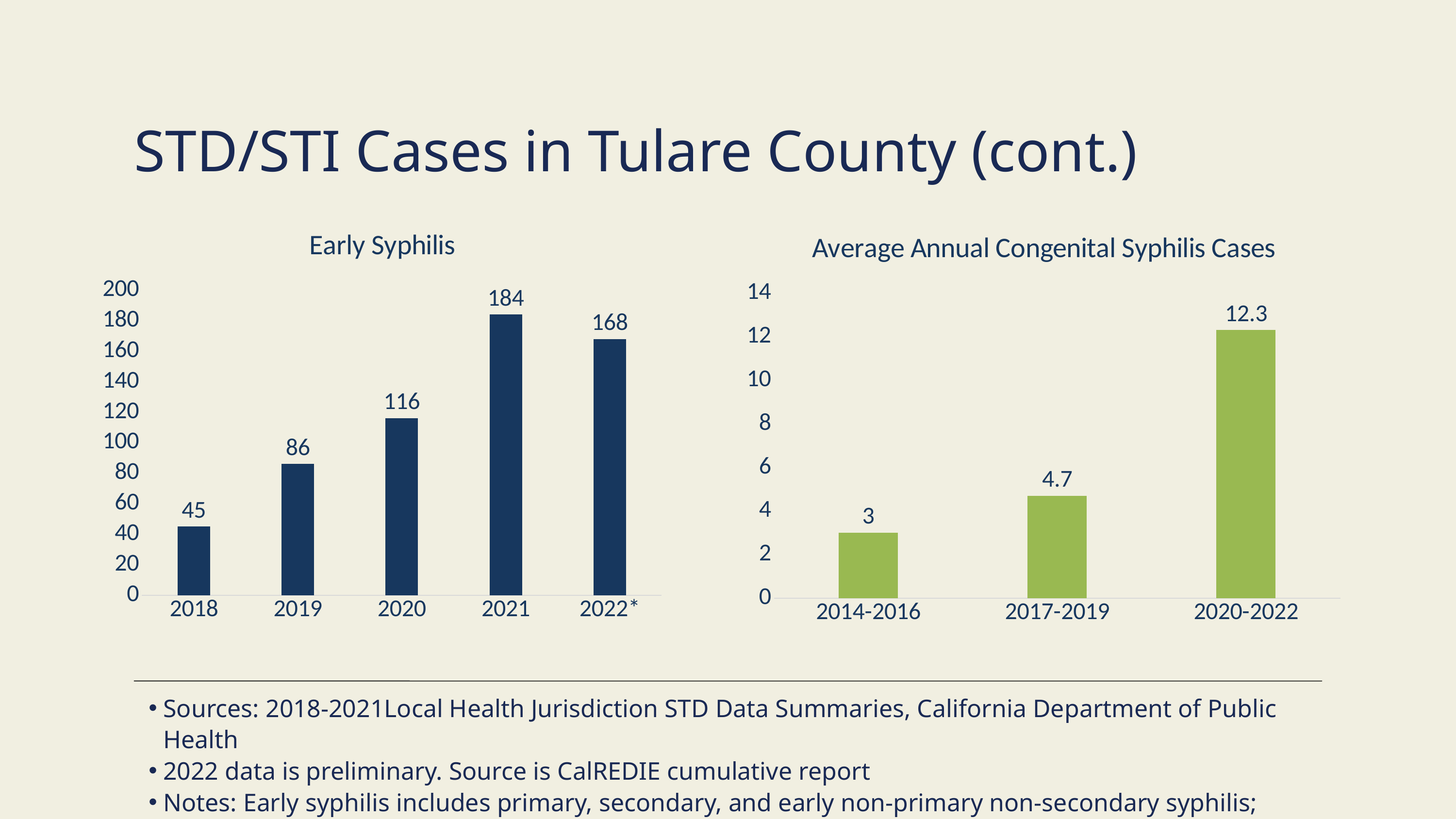
In the Early Syphilis chart, what is the difference between the values for 2021 and 2022*? 16 In the Average Annual Congenital Syphilis Cases chart, what is the value for 2017-2019? 4.7 What kind of chart is the Average Annual Congenital Syphilis Cases chart? bar chart In the Early Syphilis chart, which year has the lowest value? 2018 In the Early Syphilis chart, what is the value for 2022*? 168 In the Average Annual Congenital Syphilis Cases chart, what is the difference between the values for 2020-2022 and 2014-2016? 9.3 In the Early Syphilis chart, which is larger, the value for 2019 or the value for 2020? 2020 In the Average Annual Congenital Syphilis Cases chart, do the values rise or fall from left to right along the x axis? rise In the Average Annual Congenital Syphilis Cases chart, which period has the highest value? 2020-2022 In the Early Syphilis chart, what is the value for 2020? 116 In the Early Syphilis chart, which year has the highest value? 2021 In the Early Syphilis chart, how many years are shown on the x axis? 5